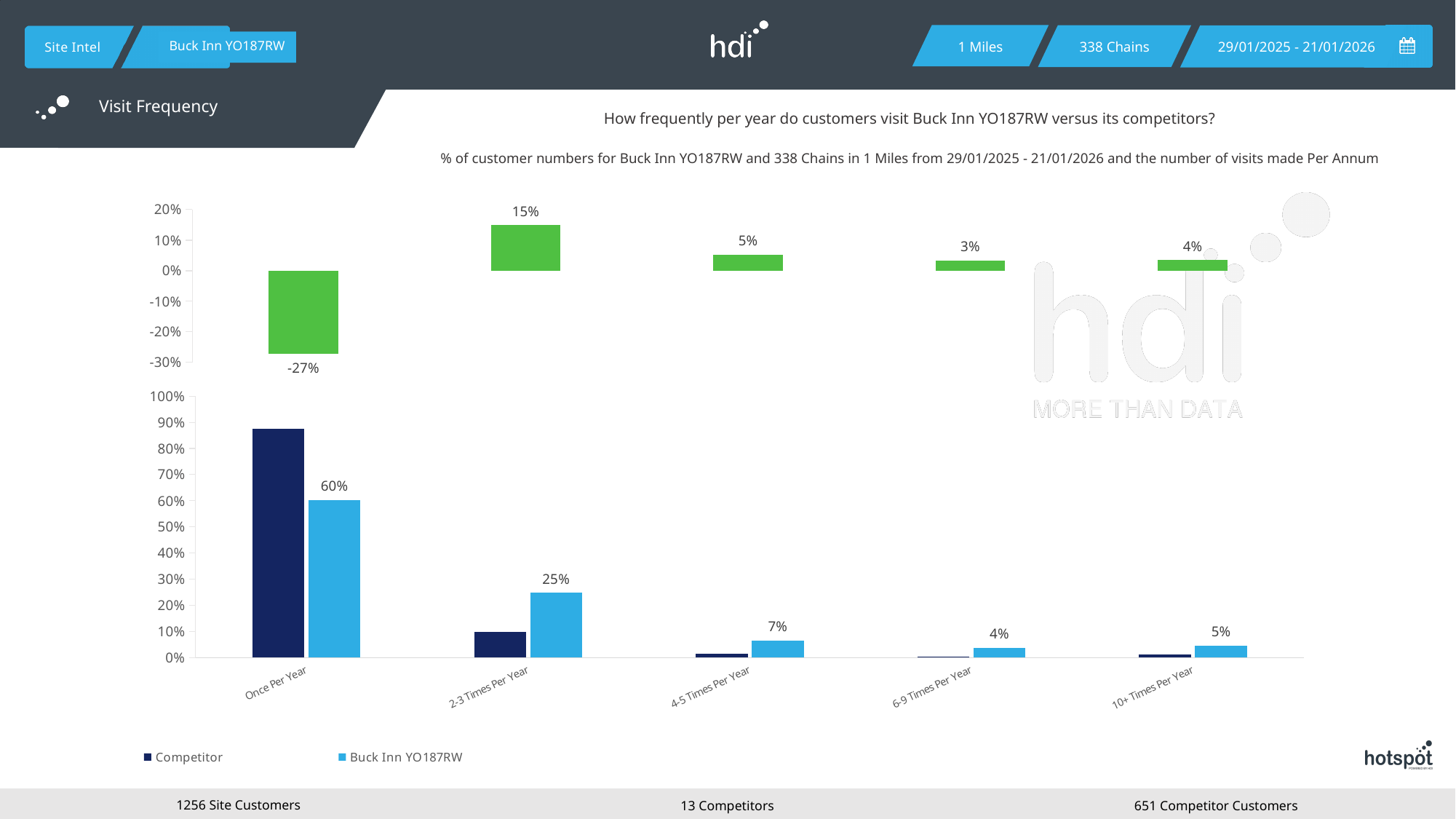
In the bottom bar chart, what is the value for Buck Inn YO187RW for 2-3 Times Per Year? 25% In the top green bar chart, what is the value shown for Once Per Year? -27% In the top green bar chart, what is the value shown for 2-3 Times Per Year? 15% In the bottom bar chart, what is the value for Buck Inn YO187RW for 4-5 Times Per Year? 7% In the bottom bar chart, what is the difference between the Buck Inn YO187RW values for Once Per Year and 2-3 Times Per Year? 35% In the bottom bar chart, for 2-3 Times Per Year, which series has the larger value, Competitor or Buck Inn YO187RW? Buck Inn YO187RW How many series does the legend of the bottom bar chart list? 2 In the bottom bar chart, is the Competitor value for Once Per Year greater or less than 80%? greater How many categories are shown on the x axis of the bottom bar chart? 5 In the bottom bar chart, which category has the highest value for Buck Inn YO187RW? Once Per Year In the bottom bar chart, which category has the lowest value for Buck Inn YO187RW? 6-9 Times Per Year In the bottom bar chart, what is the value for Buck Inn YO187RW for Once Per Year? 60%